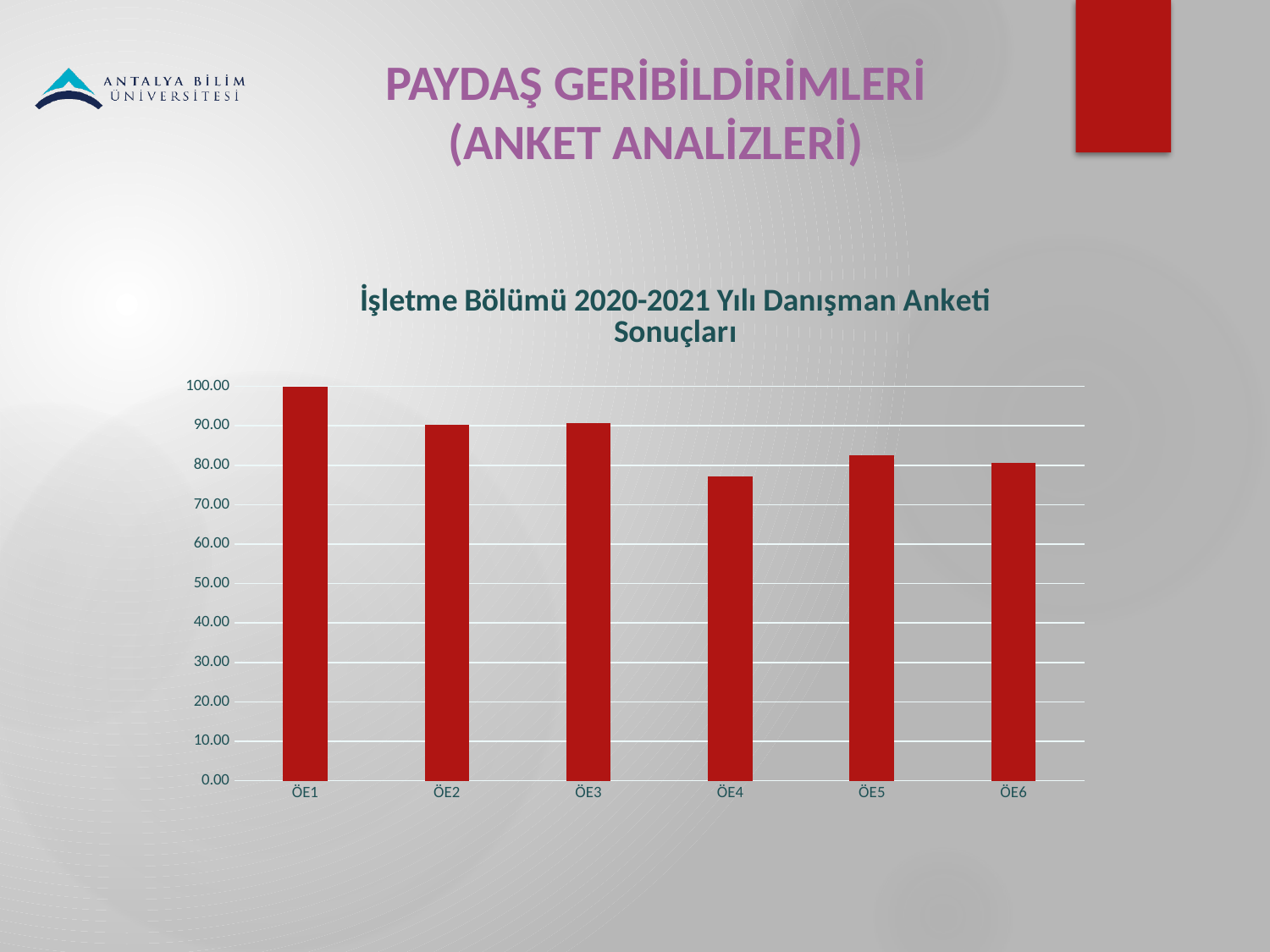
What colour are the bars in the chart? red Which is larger, the value for ÖE3 or the value for ÖE5? ÖE3 Is the value for ÖE4 greater or less than 80.00? less Which category has the highest value? ÖE1 What is the value for ÖE1? 100.00 What is the title of the chart? İşletme Bölümü 2020-2021 Yılı Danışman Anketi Sonuçları Which category has the lowest value? ÖE4 How many categories are plotted on the x axis? 6 Is the value for ÖE6 greater or less than 70.00? greater What kind of chart is shown on the slide? bar chart Is the value for ÖE5 greater or less than 80.00? greater